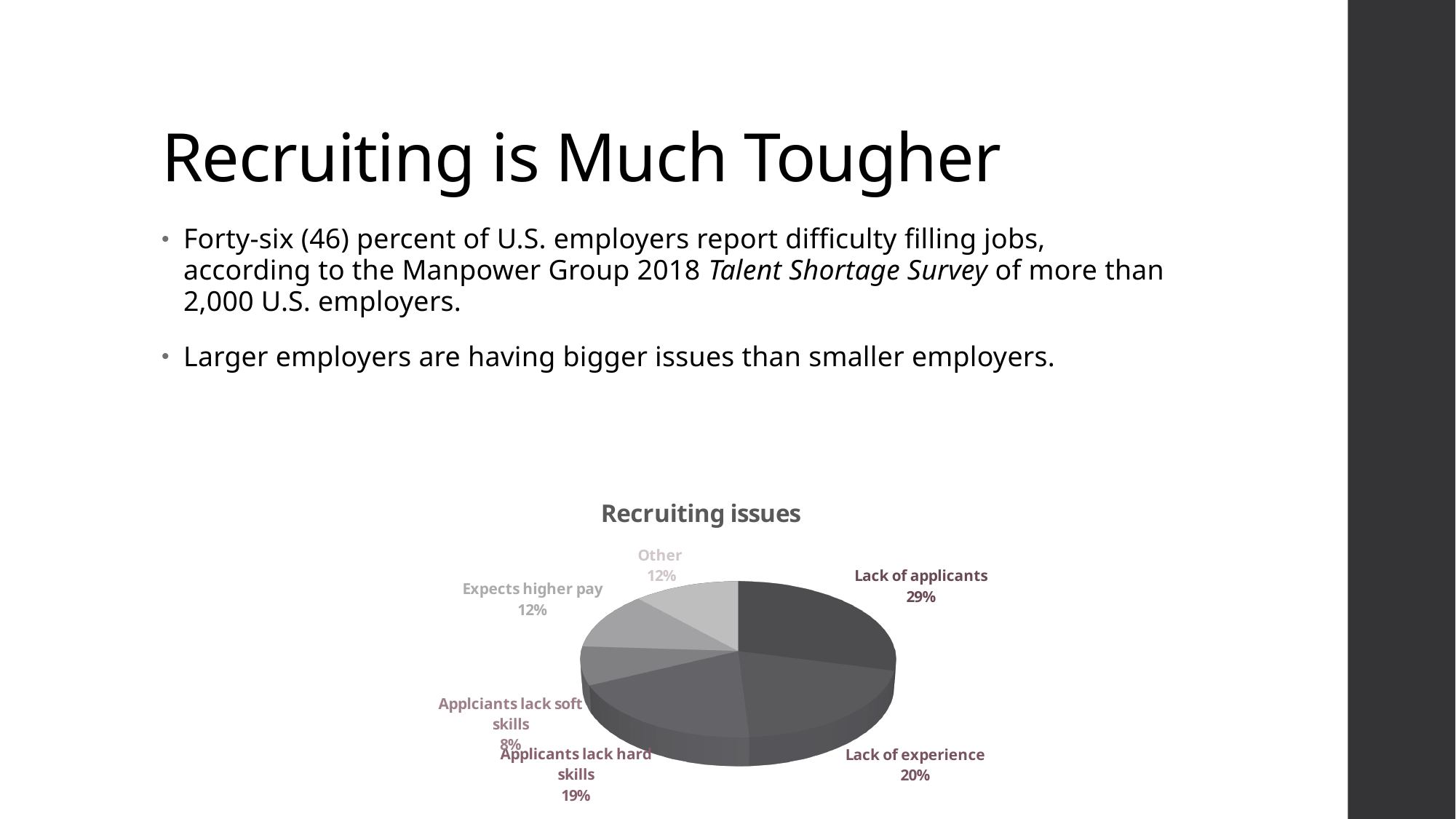
What share of the pie is labelled Applicants lack hard skills? 19% Which recruiting issue has the largest slice of the pie? Lack of applicants What share of the pie is labelled Lack of applicants? 29% What type of chart is shown on the slide? Pie chart What is the title of the chart? Recruiting issues Which is larger, the slice for Lack of experience or the slice for Applicants lack soft skills? Lack of experience What share of the pie is labelled Expects higher pay? 12% Which recruiting issue has the smallest slice of the pie? Applicants lack soft skills What is the difference in percentage points between Lack of applicants and Lack of experience? 9 What share of the pie is labelled Lack of experience? 20% What share of the pie is labelled Other? 12% How many slices does the pie chart have? 6